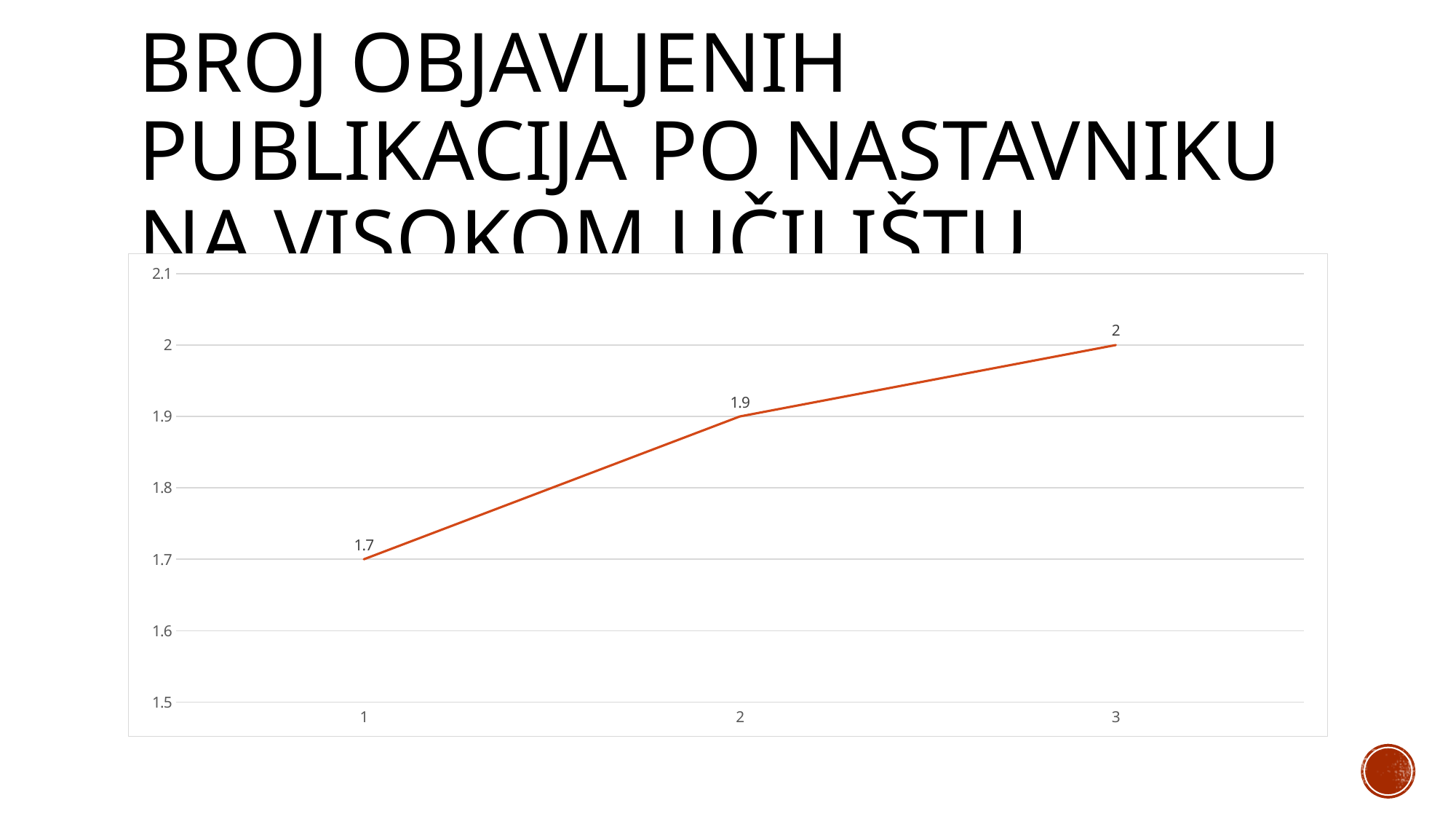
Is the value at x = 1 greater or less than 1.8? less What is the difference between the values at x = 2 and x = 1? 0.2 At which x value is the plotted value lowest? 1 How many data points are plotted on the line? 3 Which is larger, the value at x = 2 or the value at x = 3? x = 3 What is the value at x = 1? 1.7 What kind of chart is shown on the slide? line chart What is the difference between the values at x = 3 and x = 1? 0.3 Do the values rise or fall from x = 1 to x = 3? rise At which x value is the plotted value highest? 3 What is the value at x = 2? 1.9 What is the value at x = 3? 2